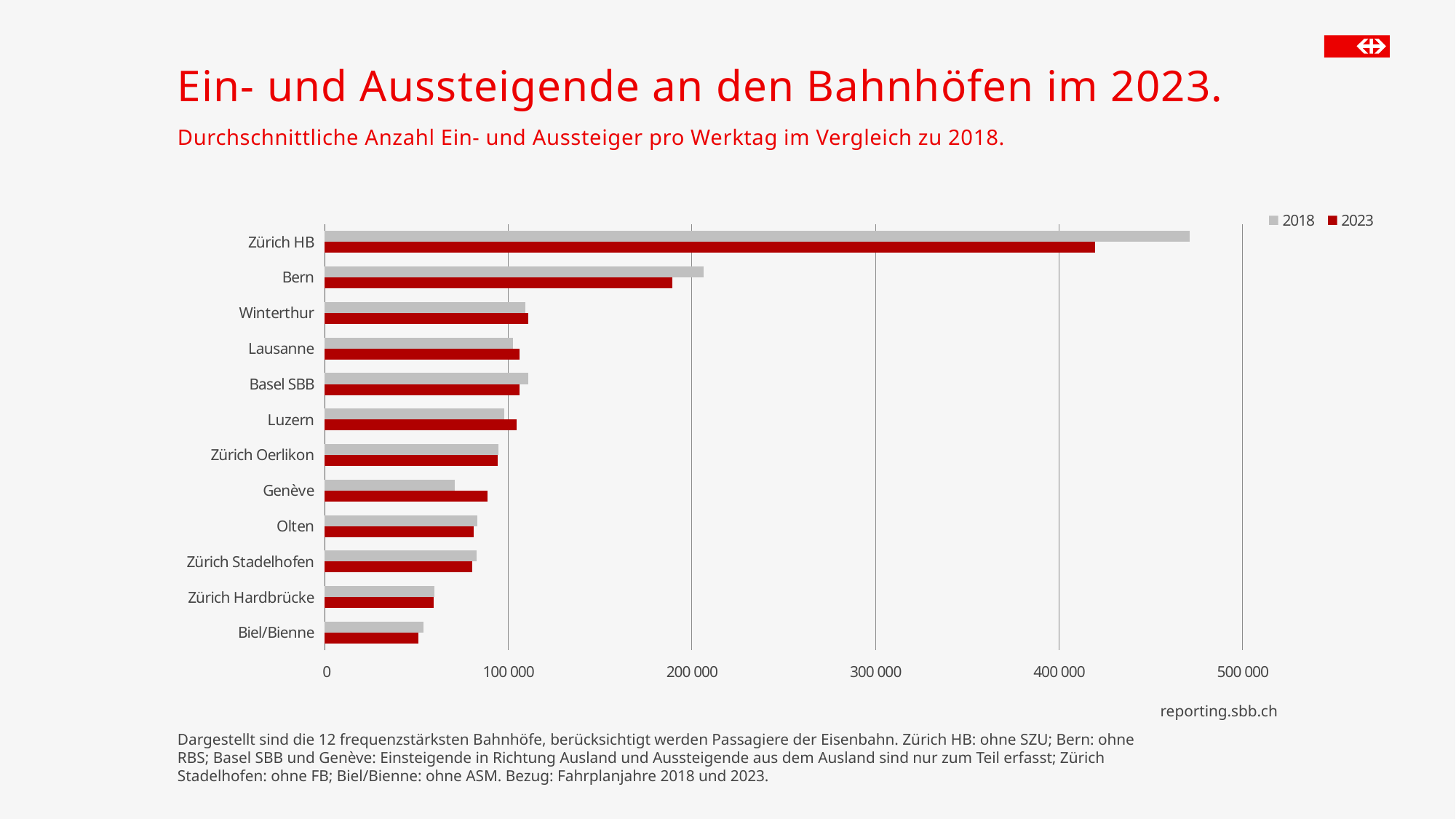
Is the 2023 value for Zürich HB greater or less than 400 000? greater Is the 2018 value for Genève greater or less than 100 000? less For Zürich HB, which year has the larger value, 2018 or 2023? 2018 Which station has the highest value for 2023? Zürich HB How many stations are shown on the chart? 12 How many series does the legend list? 2 Which station has the lowest value for 2018? Biel/Bienne Which series is shown in red in the legend? 2023 Is the 2023 value for Bern greater or less than 200 000? less What kind of chart is shown on the slide? bar chart For Genève, which year has the larger value, 2018 or 2023? 2023